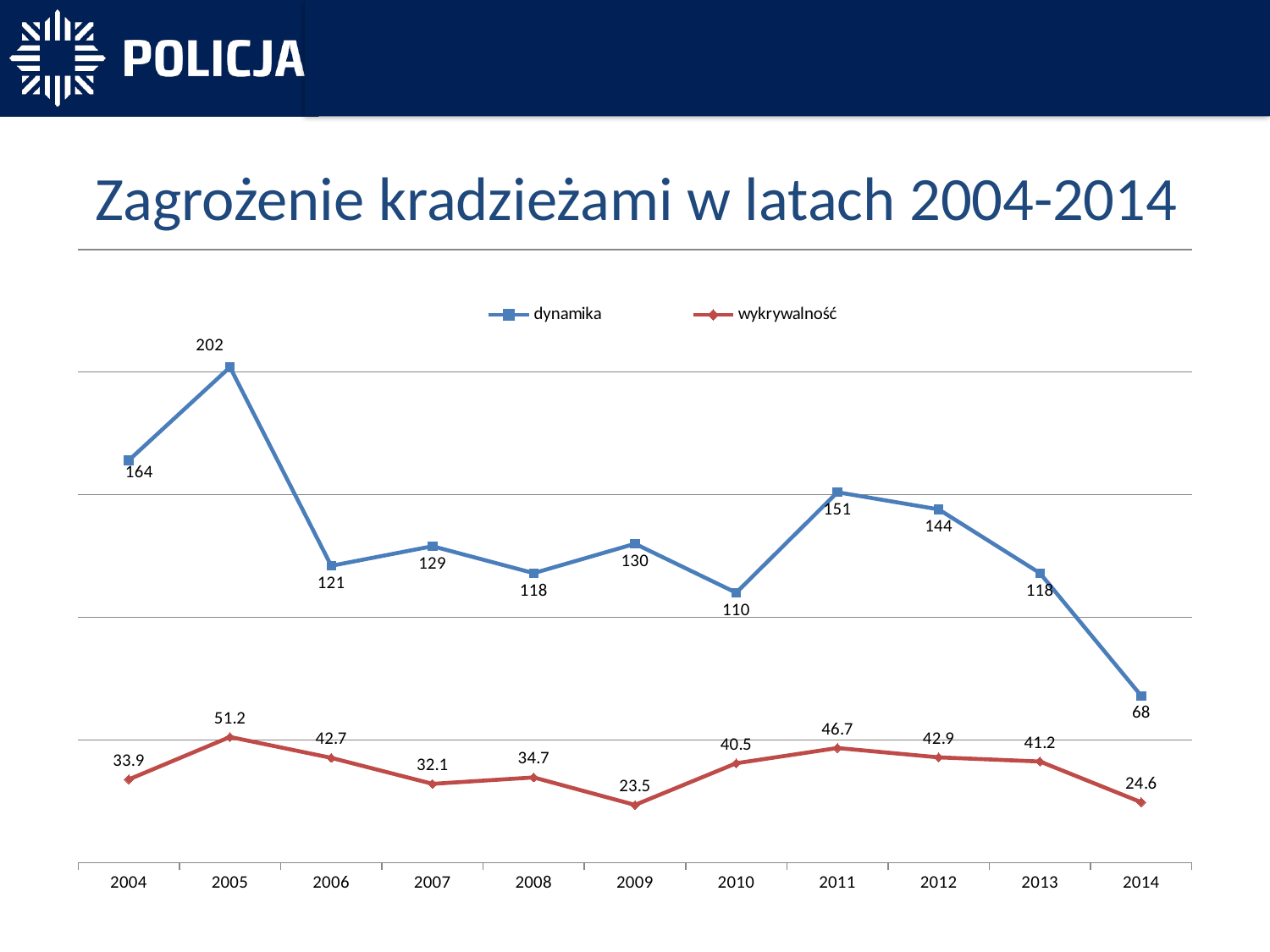
How many series does the legend list? 2 What is the title of the slide? Zagrożenie kradzieżami w latach 2004-2014 What is the value of dynamika in 2014? 68 In which year is wykrywalność highest? 2005 How many years are shown on the x axis? 11 What is the value of dynamika in 2005? 202 Does dynamika rise or fall from 2011 to 2014? fall In which year is dynamika lowest? 2014 What is the value of wykrywalność in 2009? 23.5 What is the difference between the dynamika values for 2005 and 2004? 38 What kind of chart is shown on the slide? line chart Which is larger, the wykrywalność value for 2011 or for 2012? 2011